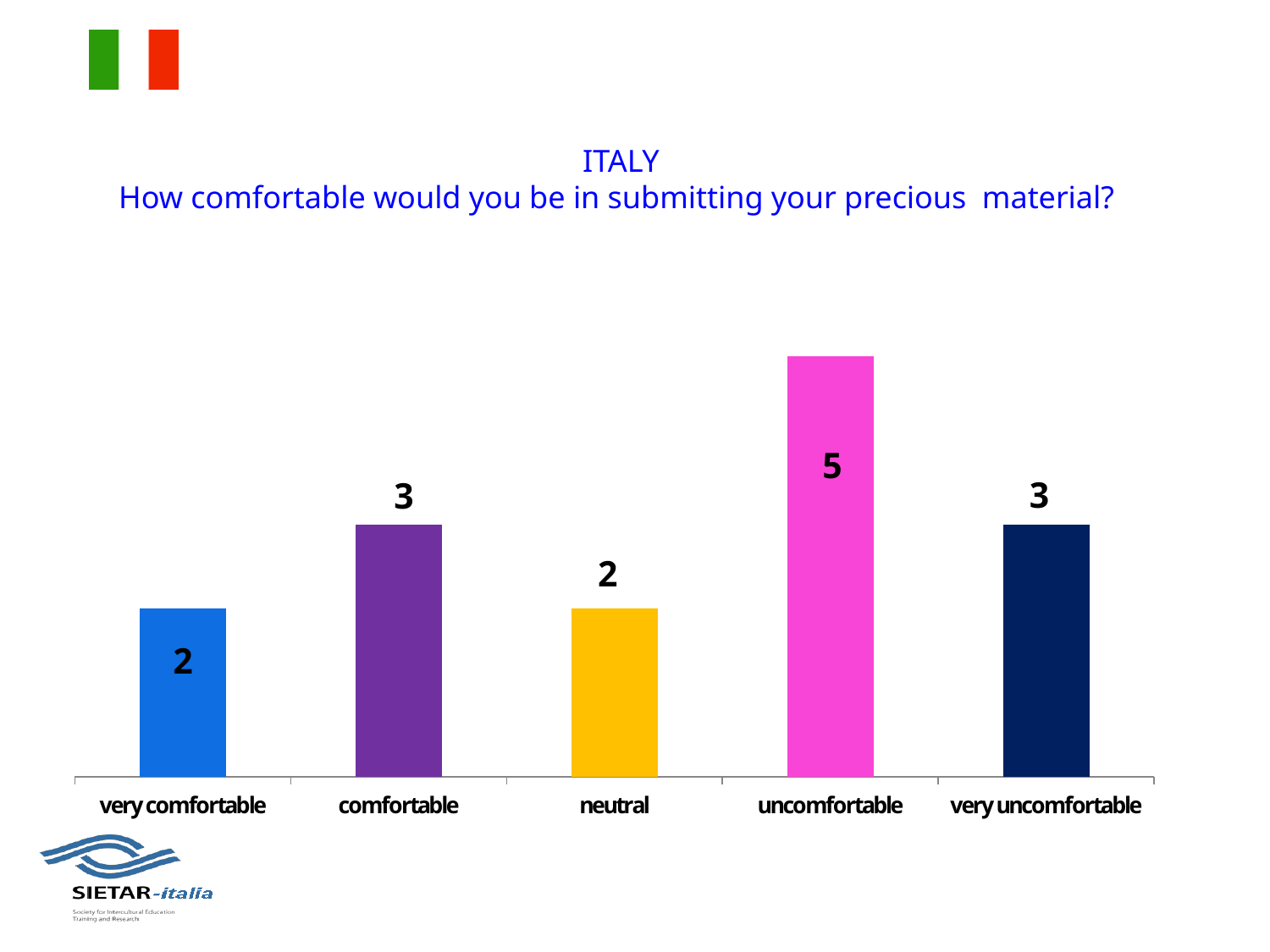
What is the value for "very comfortable"? 2 Which is larger, the value for "uncomfortable" or the value for "very uncomfortable"? uncomfortable Which is larger, the value for "comfortable" or the value for "neutral"? comfortable What is the value for "uncomfortable"? 5 How many categories are shown on the x axis? 5 What is the difference between the values for "comfortable" and "very comfortable"? 1 What is the value for "very uncomfortable"? 3 What kind of chart is shown on the slide? bar chart Which category has the highest value? uncomfortable What colour is the bar for "uncomfortable"? pink What is the value for "comfortable"? 3 What is the difference between the values for "uncomfortable" and "neutral"? 3